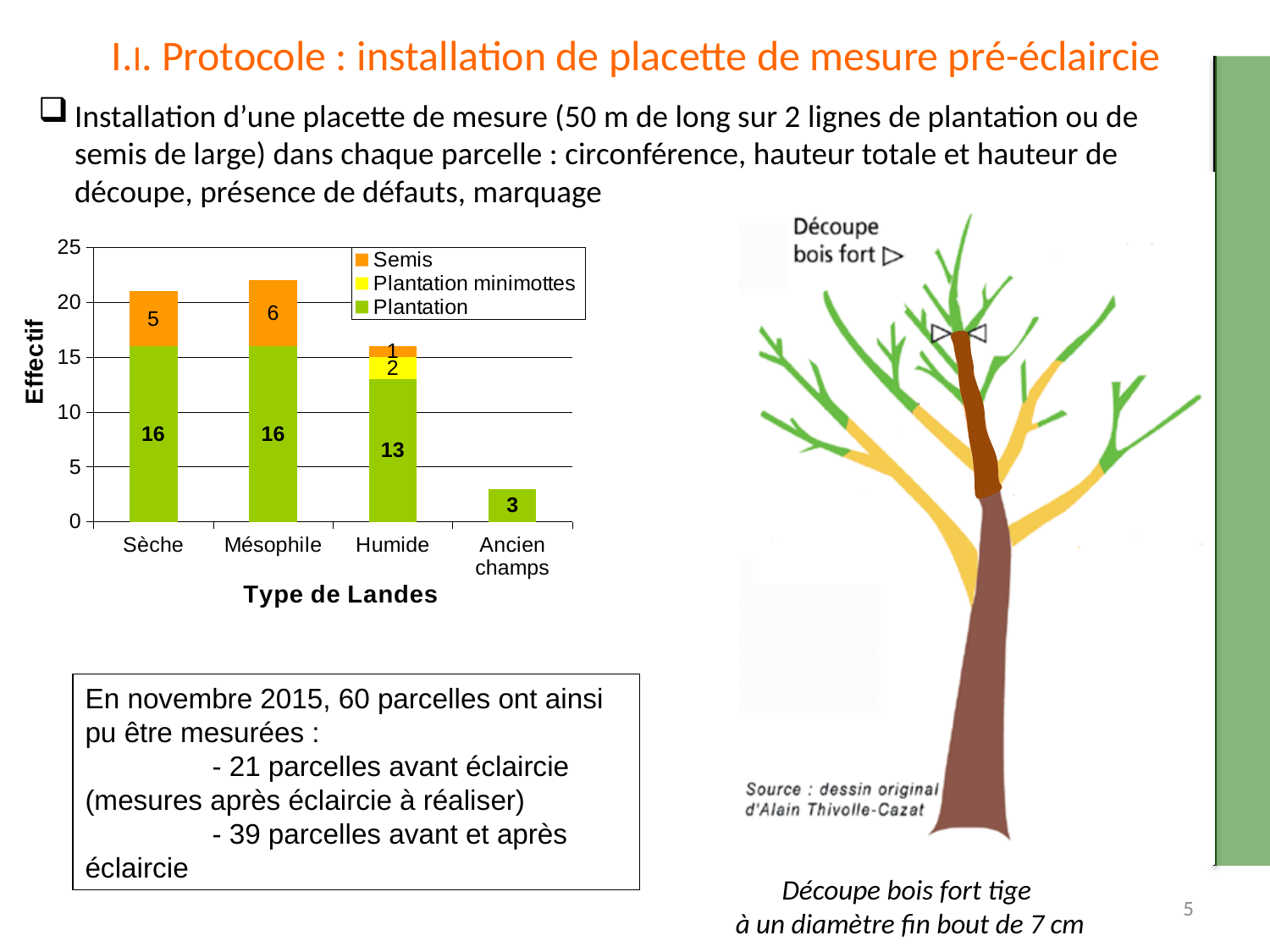
What type of chart is shown on the slide? Stacked bar chart How many series does the legend list? 3 Which category has the lowest Plantation value? Ancien champs What is the total of the stacked bar for Humide? 16 What is the Plantation value for Humide? 13 What is the difference between the Semis values for Mésophile and Sèche? 1 What is the total of the stacked bar for Sèche? 21 How many categories are shown on the x axis (Type de Landes)? 4 Is the Plantation value for Sèche greater or less than the Plantation value for Humide? greater What is the Semis value for Mésophile? 6 What is the Plantation minimottes value for Humide? 2 What is the Plantation value for Ancien champs? 3